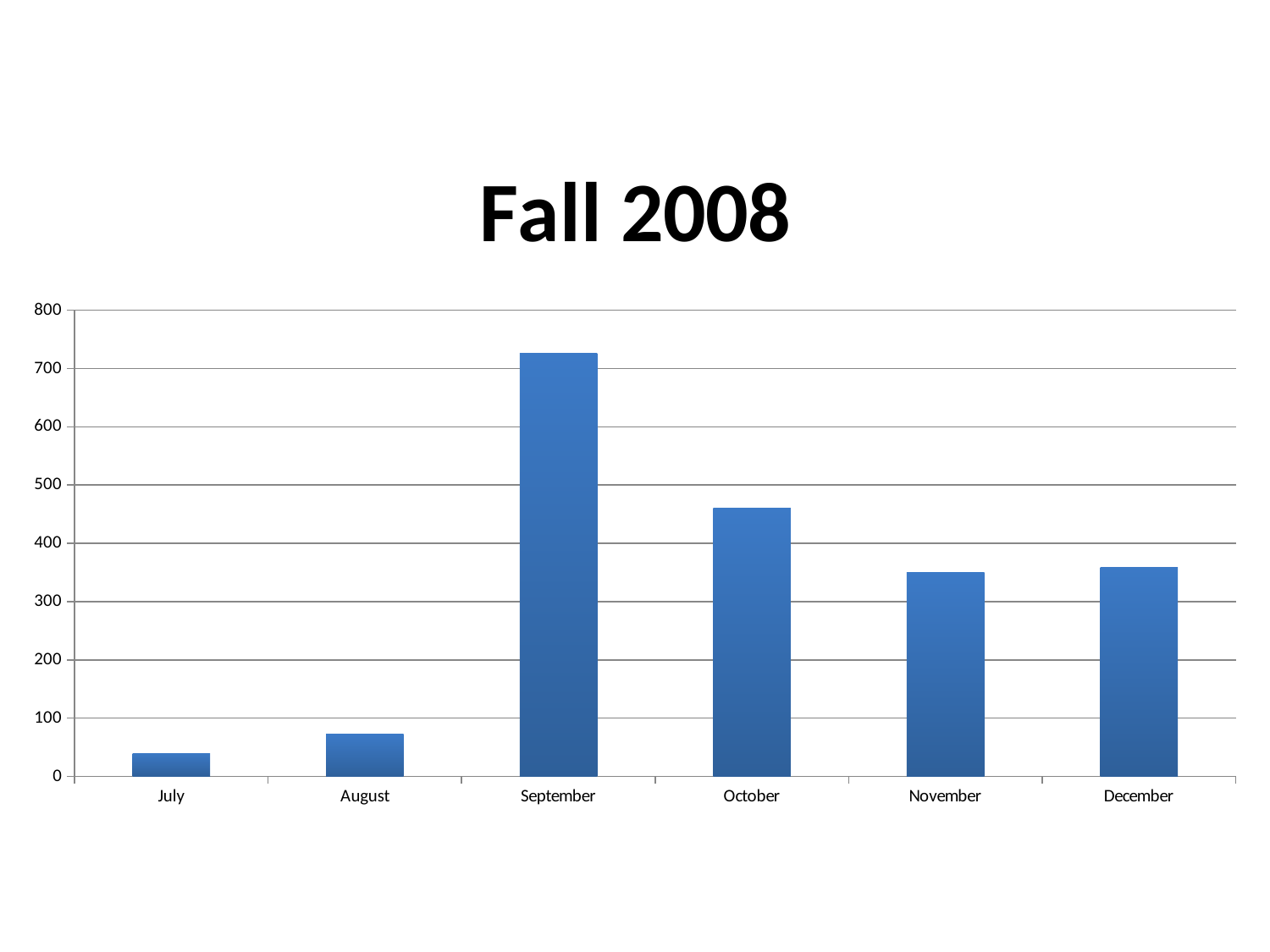
Which is larger, the value for September or the value for October? September Is the value for September greater or less than 700? greater Is the value for July greater or less than 100? less Which month has the highest bar? September Is the value for December greater or less than 300? greater How many months are shown on the x axis of the chart? 6 Which month has the lowest bar? July What kind of chart is shown on the slide? bar chart What is the title of the chart? Fall 2008 From July to September, do the values rise or fall? rise Which is larger, the value for August or the value for November? November